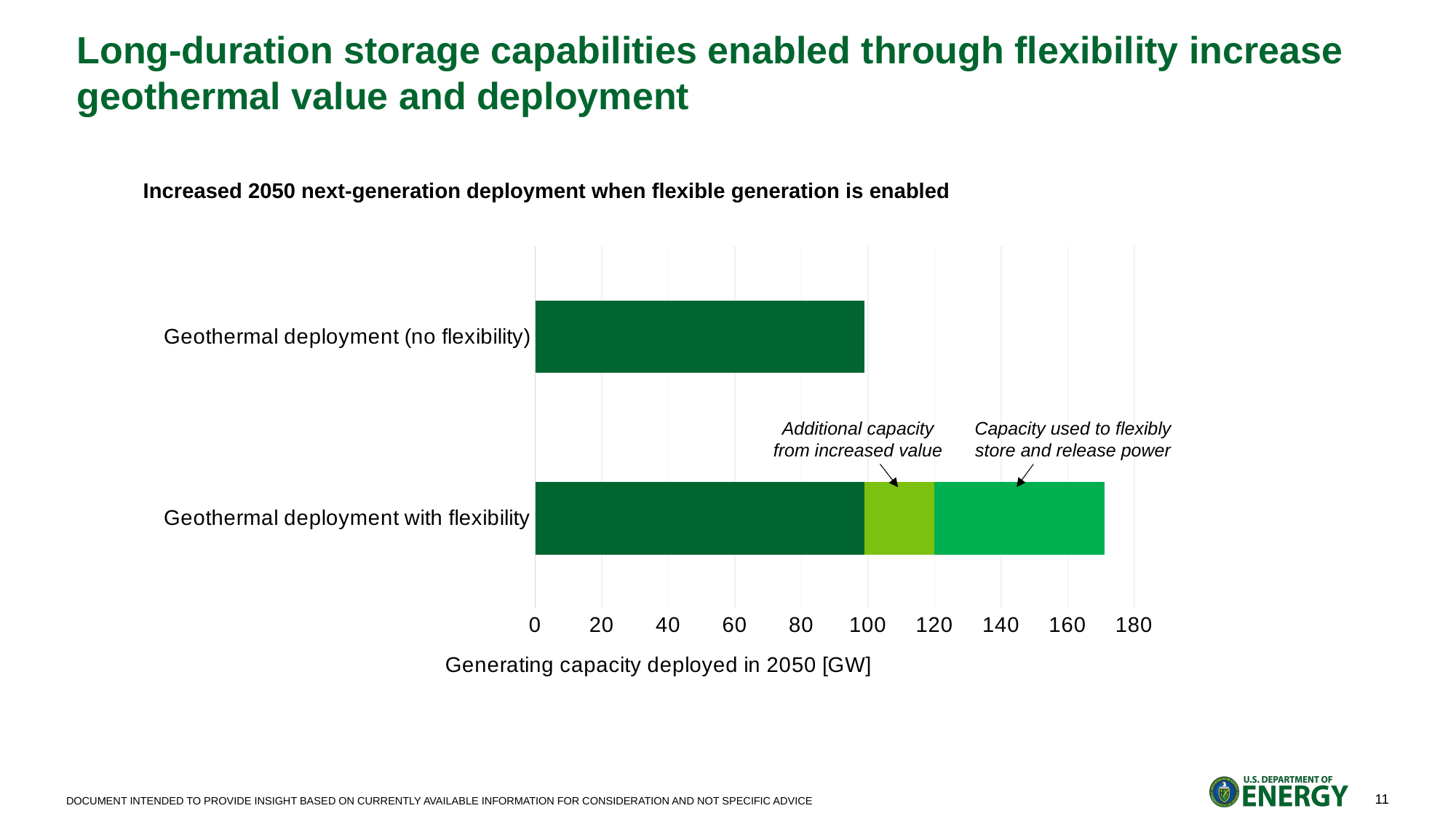
Is the total value for Geothermal deployment with flexibility greater or less than 180? less How many coloured segments make up the bar for Geothermal deployment with flexibility? 3 Which category has the larger total generating capacity deployed in 2050? Geothermal deployment with flexibility Is the total bar for Geothermal deployment with flexibility longer or shorter than the bar for Geothermal deployment (no flexibility)? longer Is the value for Geothermal deployment (no flexibility) greater or less than 120? less Is the value for Geothermal deployment (no flexibility) greater or less than 80? greater Which category has the smaller generating capacity deployed in 2050? Geothermal deployment (no flexibility) What is the label of the horizontal axis? Generating capacity deployed in 2050 [GW] How many categories are shown on the chart? 2 What is the title of the chart? Increased 2050 next-generation deployment when flexible generation is enabled What kind of chart is shown on the slide? bar chart